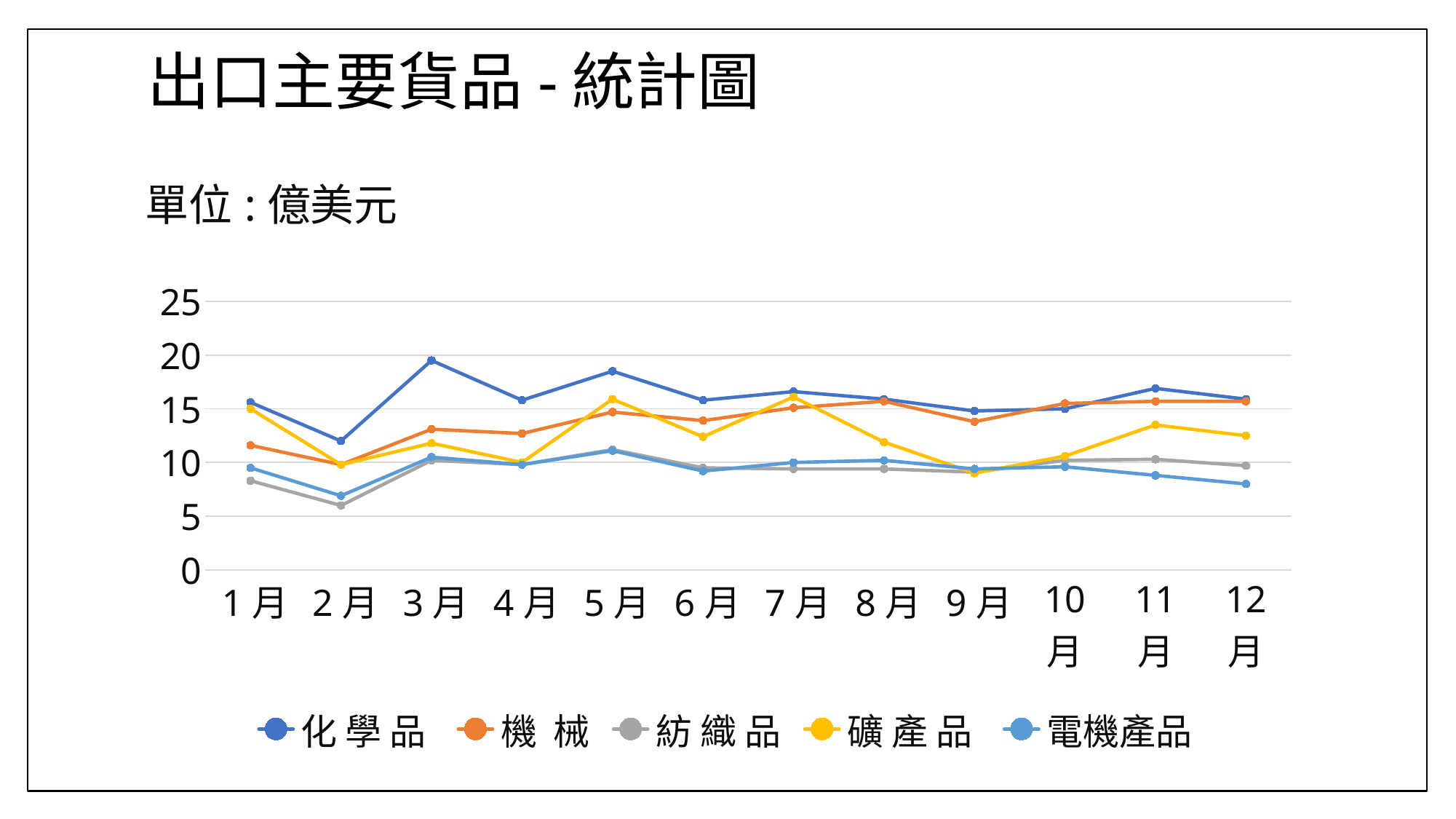
In which month is the value for 電機產品 lowest? 2月 In which month is the value for 紡織品 lowest? 2月 How many series does the legend list? 5 Is the value for 礦產品 in 9月 greater or less than 10? less Is the value for 化學品 in 3月 greater or less than 15? greater What unit is stated for the values on the slide? 億美元 How many months are plotted along the x axis? 12 In 1月, which is larger: 化學品 or 機械? 化學品 In which month is the value for 化學品 highest? 3月 Is the value for 紡織品 in 2月 greater or less than 10? less What kind of chart is shown on the slide? line chart Does the value for 電機產品 rise or fall from 10月 to 12月? fall